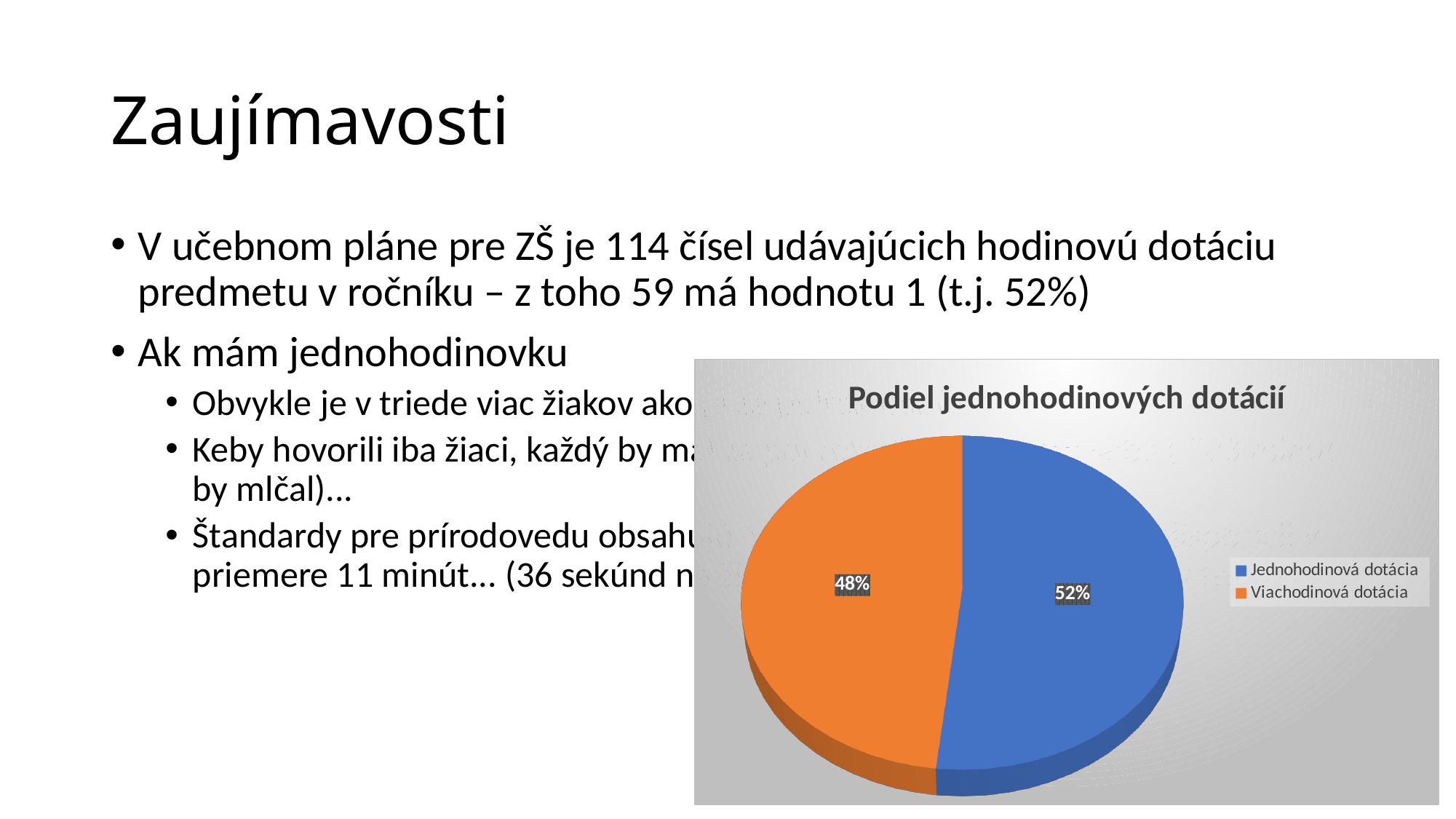
What kind of chart is shown on the slide? pie chart Which slice of the pie is the smallest? Viachodinová dotácia What share of the pie does Jednohodinová dotácia have? 52% Which is larger, the Jednohodinová dotácia slice or the Viachodinová dotácia slice? Jednohodinová dotácia Which slice of the pie is the largest? Jednohodinová dotácia What share of the pie does Viachodinová dotácia have? 48% How many entries does the legend list? 2 What is the title of the chart? Podiel jednohodinových dotácií What is the difference in percentage points between the Jednohodinová dotácia and Viachodinová dotácia slices? 4 What colour is the Viachodinová dotácia slice? orange How many slices does the pie chart have? 2